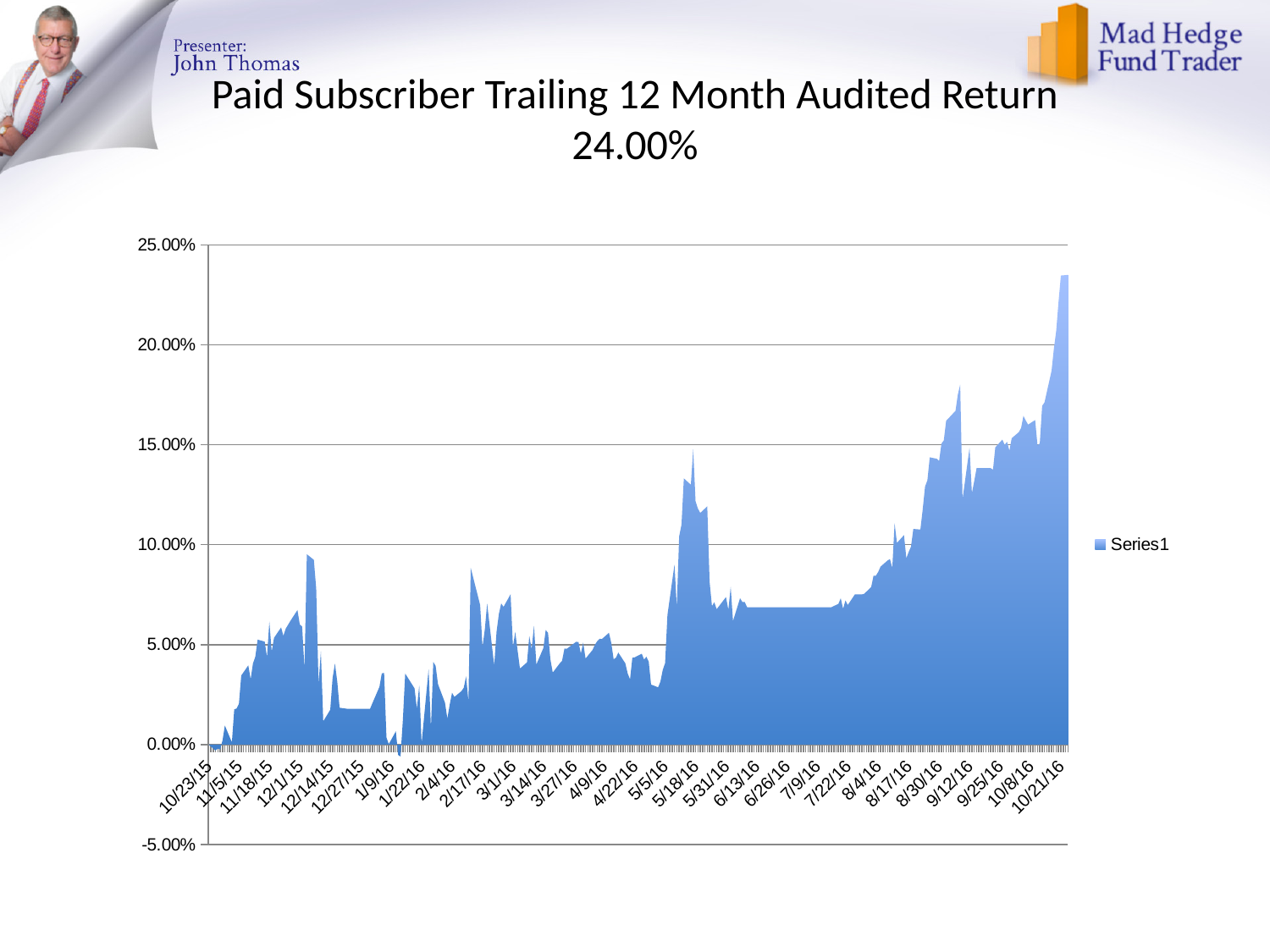
Overall, do the values rise or fall from 10/23/15 to 10/21/16? rise Is the value at 6/26/16 greater or less than 10.00%? less Is the value at 10/21/16 greater or less than 20.00%? greater Is the value at 7/9/16 greater or less than 10.00%? less What kind of chart is shown on the slide? area chart How many series does the legend list? 1 What is the name of the series shown in the legend? Series1 Which date on the x axis has the highest value? 10/21/16 What is the highest tick value shown on the y axis? 25.00% What is the title of the chart on the slide? Paid Subscriber Trailing 12 Month Audited Return 24.00% Which of the two is larger: the value at 10/21/16 or the value at 5/31/16? 10/21/16